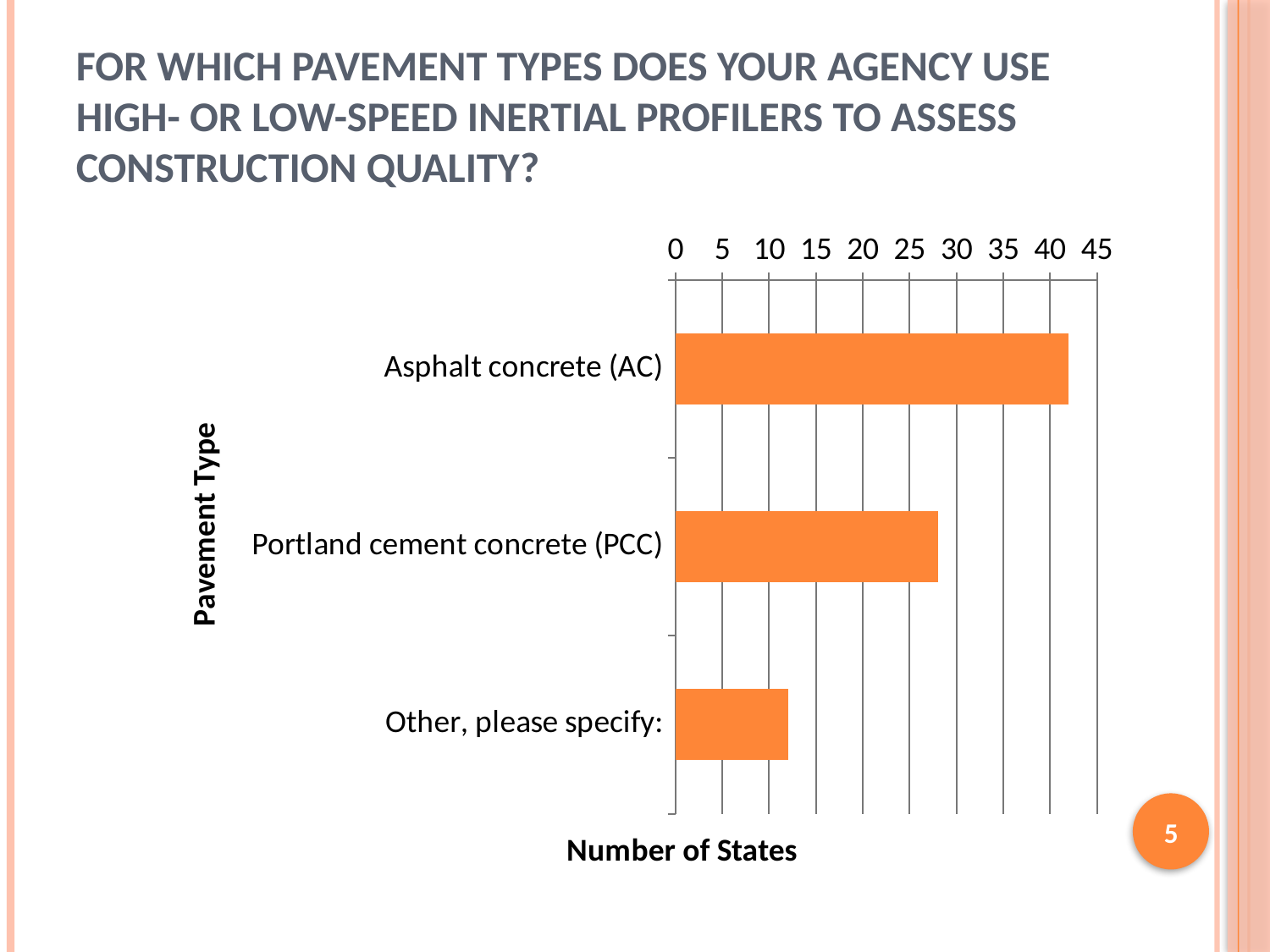
Is the value for Asphalt concrete (AC) greater or less than 40? greater What kind of chart is shown on the slide? bar chart Is the value for Other, please specify: greater or less than 15? less Which pavement type has the lowest number of states? Other, please specify: What is the title of the vertical axis of the chart? Pavement Type Which has more states, Portland cement concrete (PCC) or Other, please specify:? Portland cement concrete (PCC) Which pavement type has the highest number of states? Asphalt concrete (AC) Is the value for Portland cement concrete (PCC) greater or less than 30? less How many pavement type categories are plotted in the chart? 3 Which has more states, Asphalt concrete (AC) or Portland cement concrete (PCC)? Asphalt concrete (AC) What is the title of the horizontal axis of the chart? Number of States